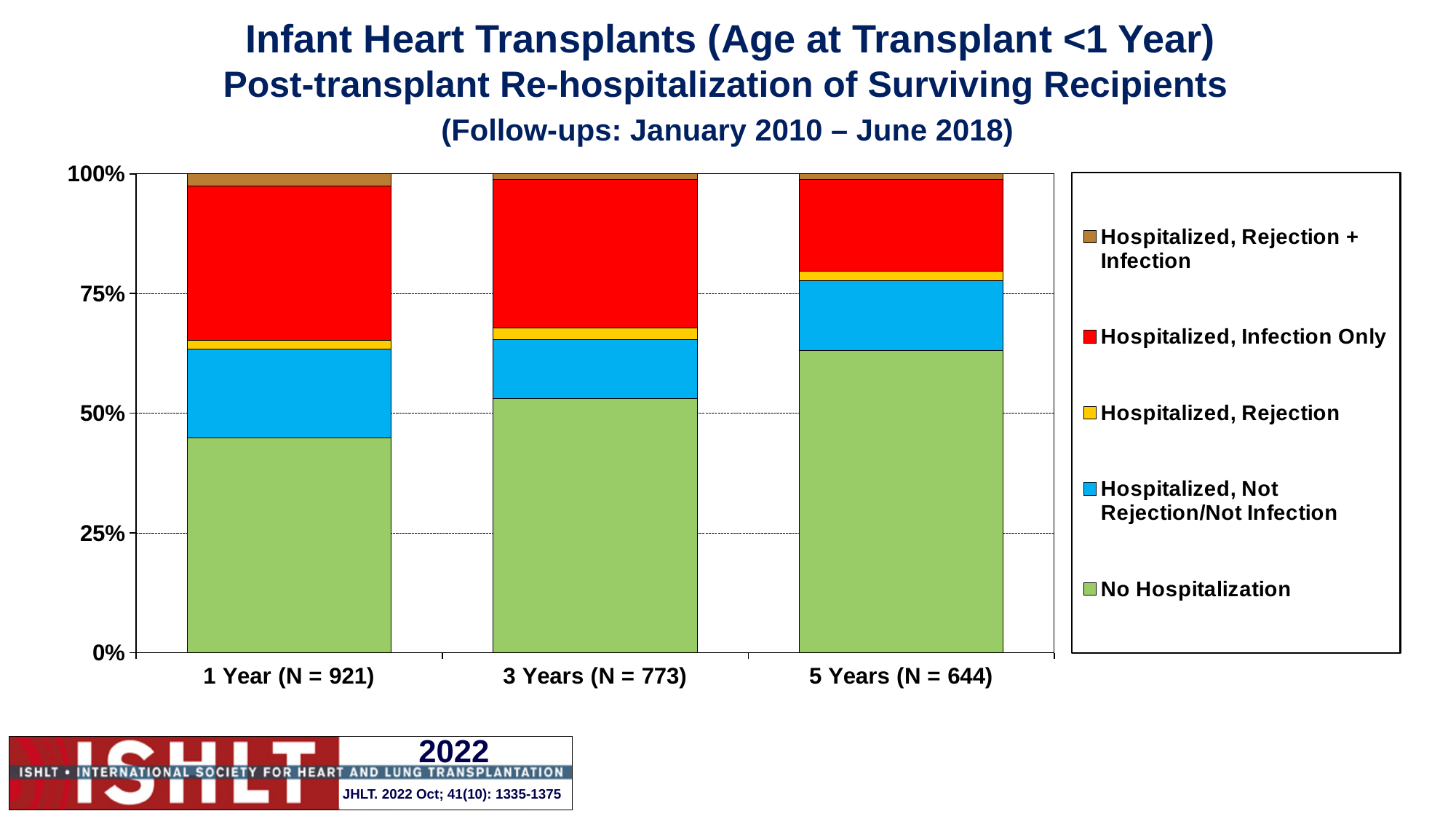
Which has the larger Hospitalized, Infection Only share: 1 Year (N = 921) or 5 Years (N = 644)? 1 Year (N = 921) How many follow-up time categories are shown on the x axis? 3 What colour represents No Hospitalization in the legend? Green How many series does the legend list? 5 What is the N shown for the 3 Years category? 773 At which follow-up time is the Hospitalized, Infection Only share the smallest? 5 Years (N = 644) At which follow-up time is the No Hospitalization share the highest? 5 Years (N = 644) Is the No Hospitalization share at 1 Year (N = 921) greater or less than 50%? less Does the No Hospitalization share rise or fall from 1 Year to 5 Years? rise Is the No Hospitalization share at 3 Years (N = 773) greater or less than 50%? greater Is the No Hospitalization share at 5 Years (N = 644) greater or less than 50%? greater What kind of chart is shown on the slide? Stacked bar chart